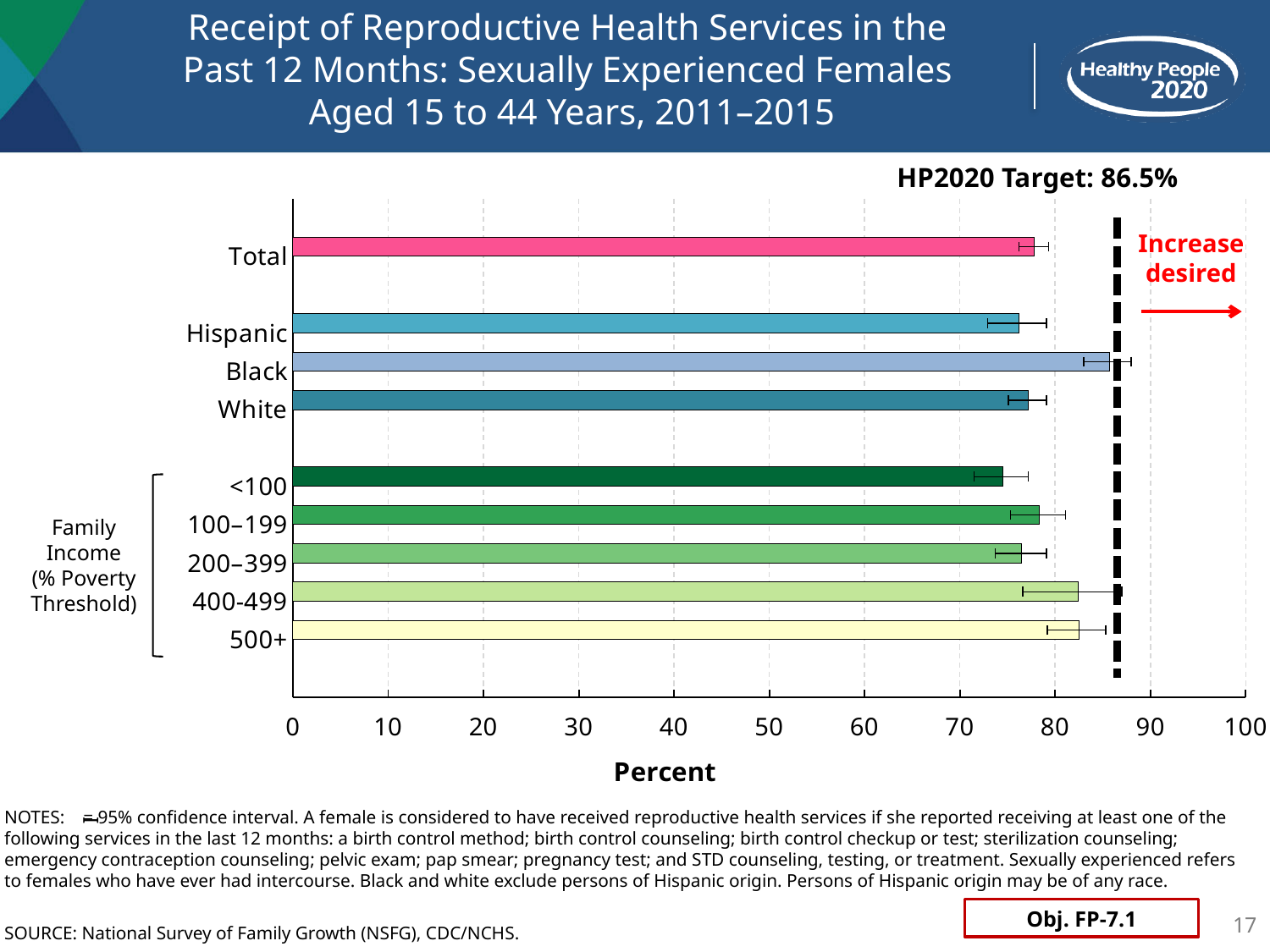
Is the value for <100 greater or less than 70? greater Which is larger, the value for Black or the value for White? Black How many bars (categories) are plotted in the chart? 9 Which is larger, the value for 400-499 or the value for <100? 400-499 What is the HP2020 Target value shown on the slide? 86.5% What kind of chart is shown on the slide? bar chart What is the label of the x axis? Percent Is the value for Black greater or less than 80? greater Is the value for Total greater or less than 80? less Which category has the highest value in the chart? Black Among the family income groups, which has the lowest value? <100